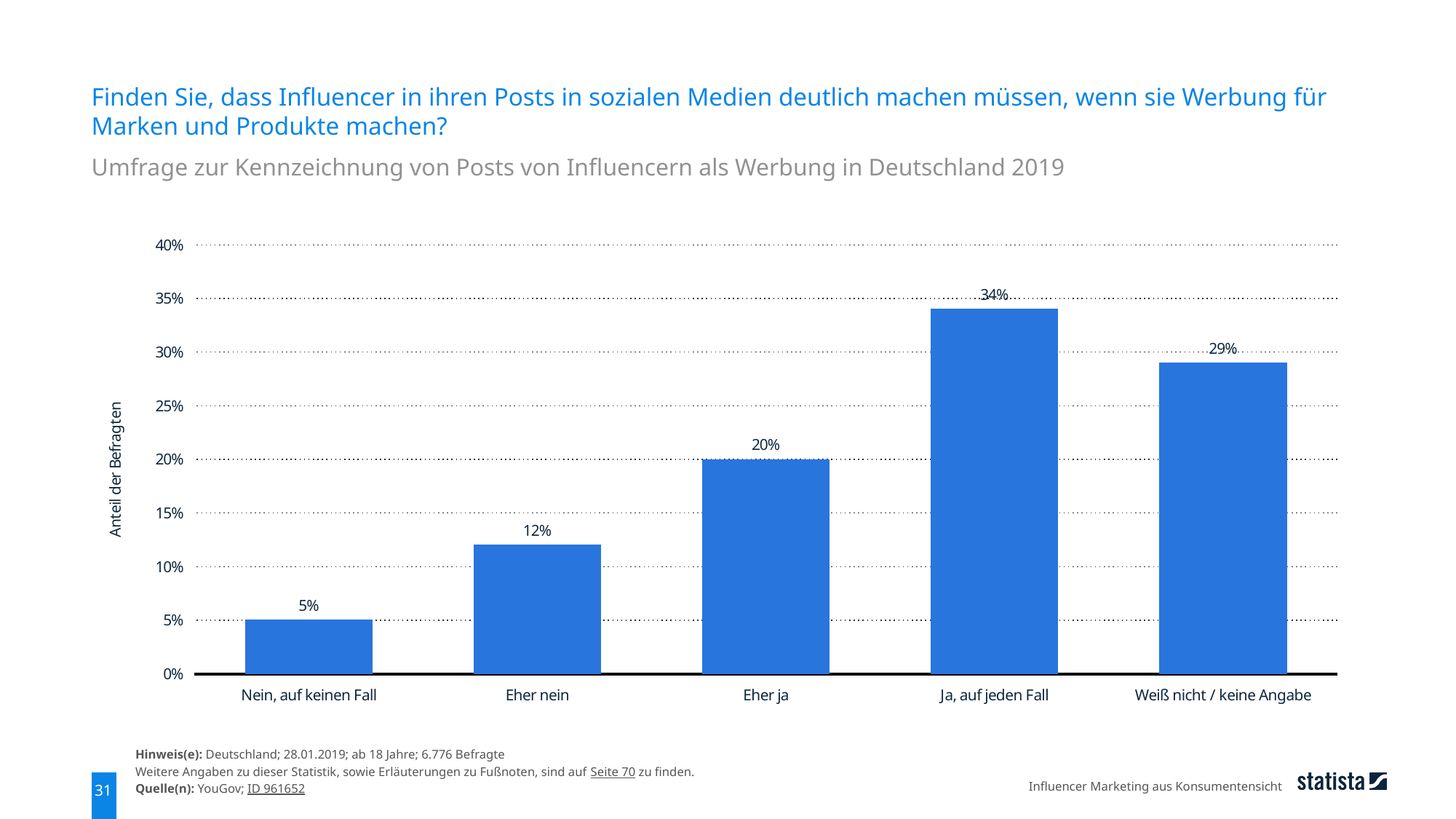
Which is larger, the value for "Eher ja" or the value for "Weiß nicht / keine Angabe"? Weiß nicht / keine Angabe What is the label of the y axis? Anteil der Befragten What is the difference between the values for "Ja, auf jeden Fall" and "Eher ja"? 14% What is the value for "Weiß nicht / keine Angabe"? 29% How many categories are shown on the x axis? 5 What is the value for "Ja, auf jeden Fall"? 34% Which category has the highest value? Ja, auf jeden Fall What is the value for "Nein, auf keinen Fall"? 5% Which category has the lowest value? Nein, auf keinen Fall What is the difference between the values for "Eher nein" and "Nein, auf keinen Fall"? 7% What kind of chart is shown on the slide? bar chart Is the value for "Eher nein" greater or less than 15%? less